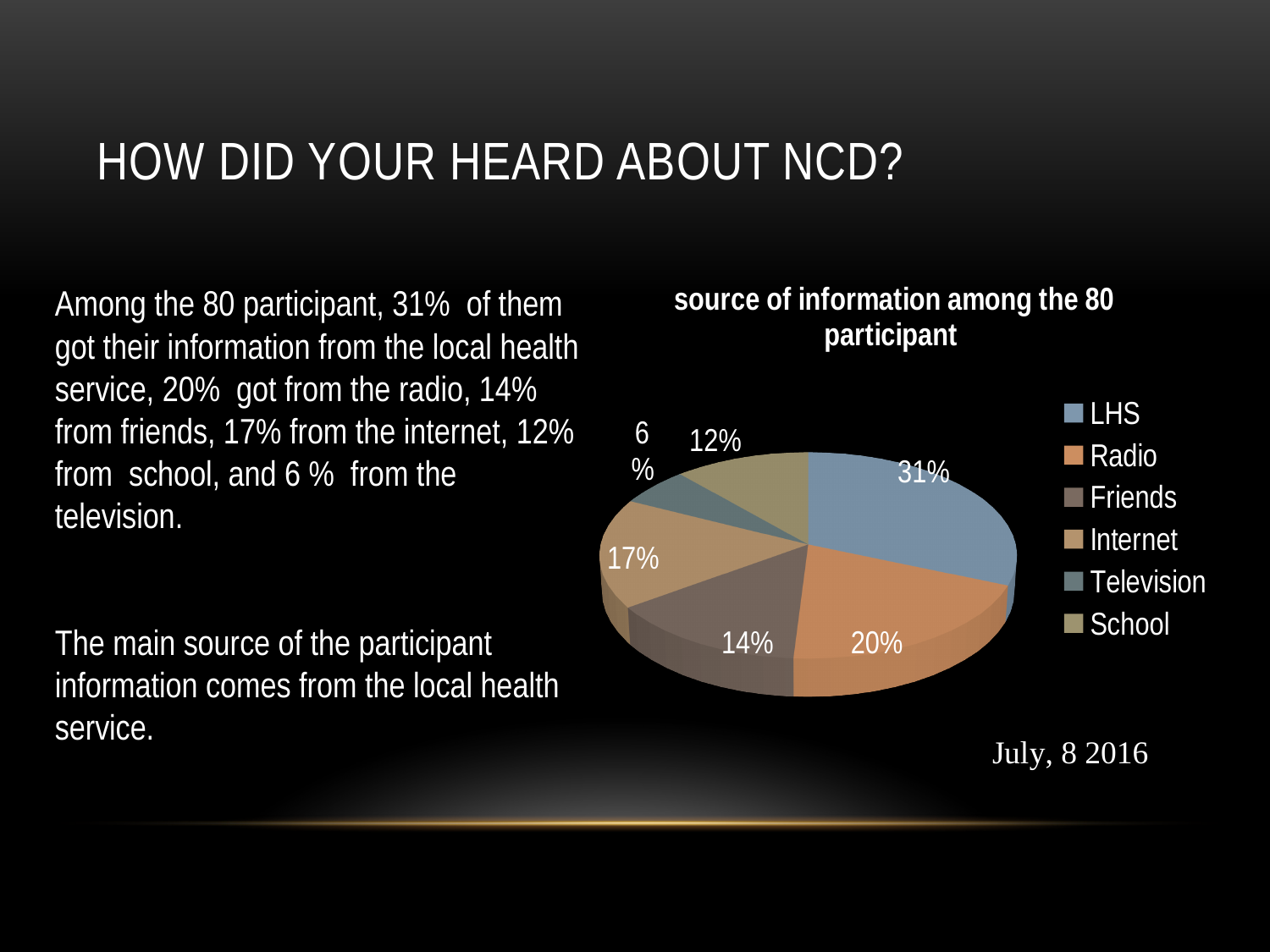
What share of the pie does Friends have? 14% Which category has the largest slice of the pie? LHS How many categories does the legend list? 6 What share of the pie does Radio have? 20% What is the title of the chart? source of information among the 80 participant Which is larger, the Internet slice or the Friends slice? Internet What share of the pie does Internet have? 17% What share of the pie does School have? 12% What share of the pie does LHS have? 31% Which category has the smallest slice of the pie? Television What is the difference between the LHS share and the Radio share? 11% What kind of chart is shown on the slide? pie chart